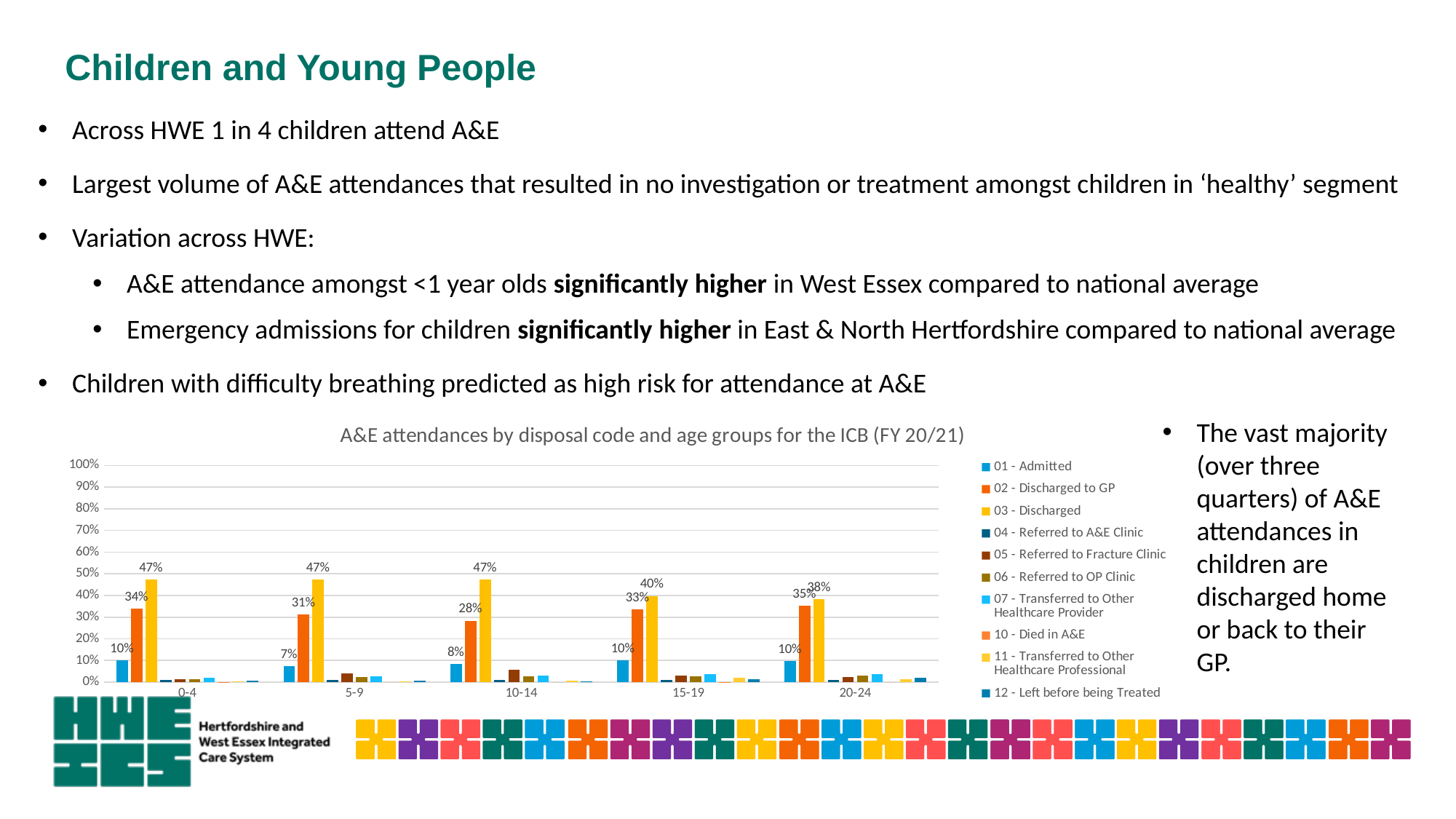
What is the value for 01 - Admitted in the 5-9 age group? 7% Which age group has the lowest value for 03 - Discharged? 20-24 How many series does the legend list? 10 What is the value for 03 - Discharged in the 20-24 age group? 38% What is the value for 03 - Discharged in the 0-4 age group? 47% How many age groups are shown on the x axis? 5 Which age group has the highest value for 02 - Discharged to GP? 20-24 What is the value for 02 - Discharged to GP in the 10-14 age group? 28% What is the title of the chart? A&E attendances by disposal code and age groups for the ICB (FY 20/21) Is the value for 02 - Discharged to GP in the 5-9 age group larger or smaller than in the 0-4 age group? smaller What kind of chart is shown on the slide? bar chart What is the difference between 03 - Discharged and 02 - Discharged to GP in the 15-19 age group? 7%